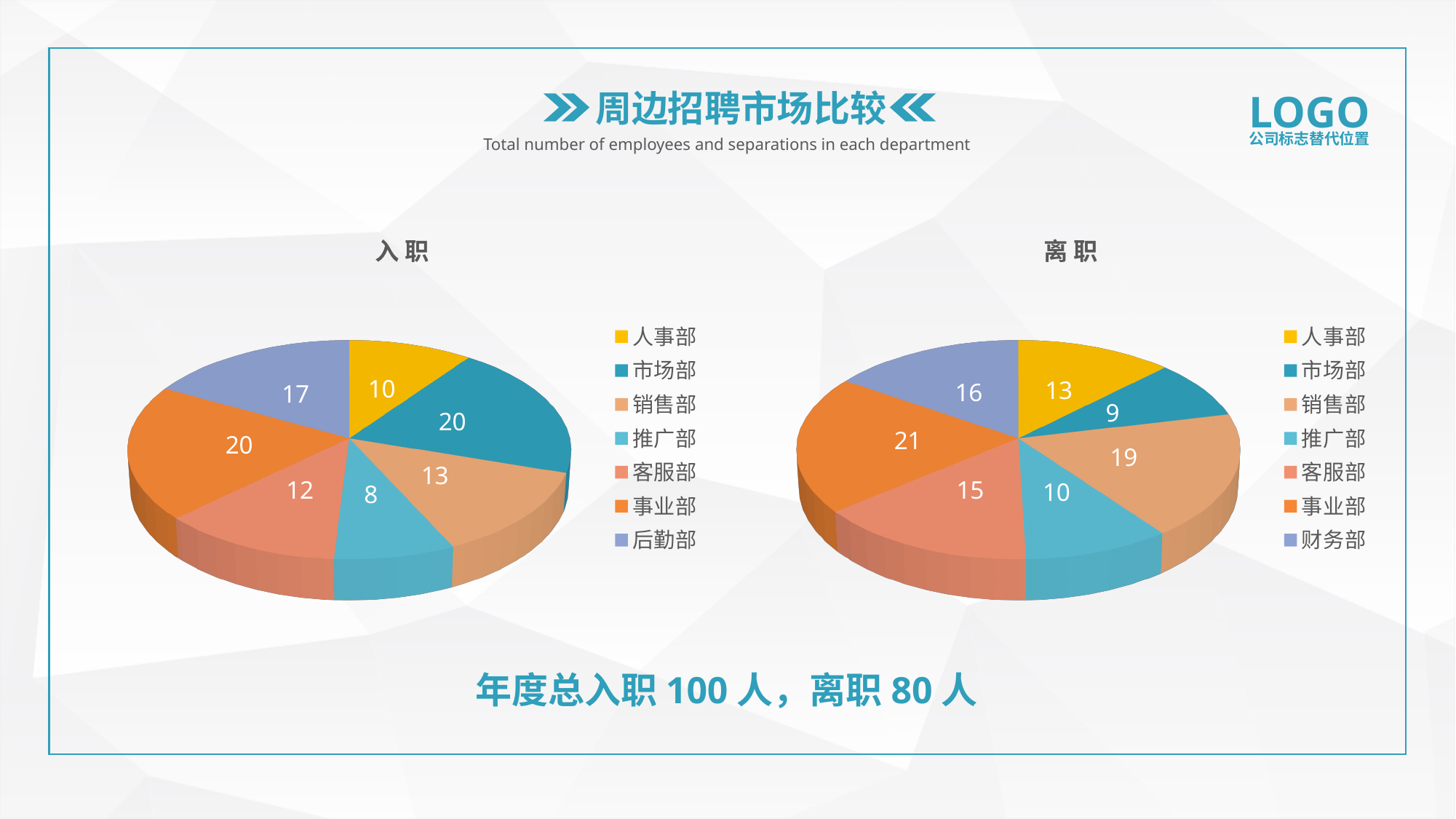
In the 入职 pie chart, what is the difference between the values for 后勤部 and 客服部? 5 In the 离职 pie chart, what is the difference between the values for 事业部 and 市场部? 12 In the 离职 pie chart, which department has the largest slice? 事业部 In the 离职 pie chart, what is the value for 事业部? 21 Which legend entry appears in the 离职 chart but not in the 入职 chart? 财务部 In the 入职 pie chart, what share of the total does 市场部 represent? 20% How many slices does the 入职 pie chart have? 7 In the 入职 pie chart, what is the value for 销售部? 13 What type of chart is the 离职 chart? pie chart In the 入职 pie chart, which department has the smallest slice? 推广部 In the 离职 pie chart, which department has the smallest slice? 市场部 In the 离职 pie chart, which is larger, the value for 销售部 or the value for 客服部? 销售部